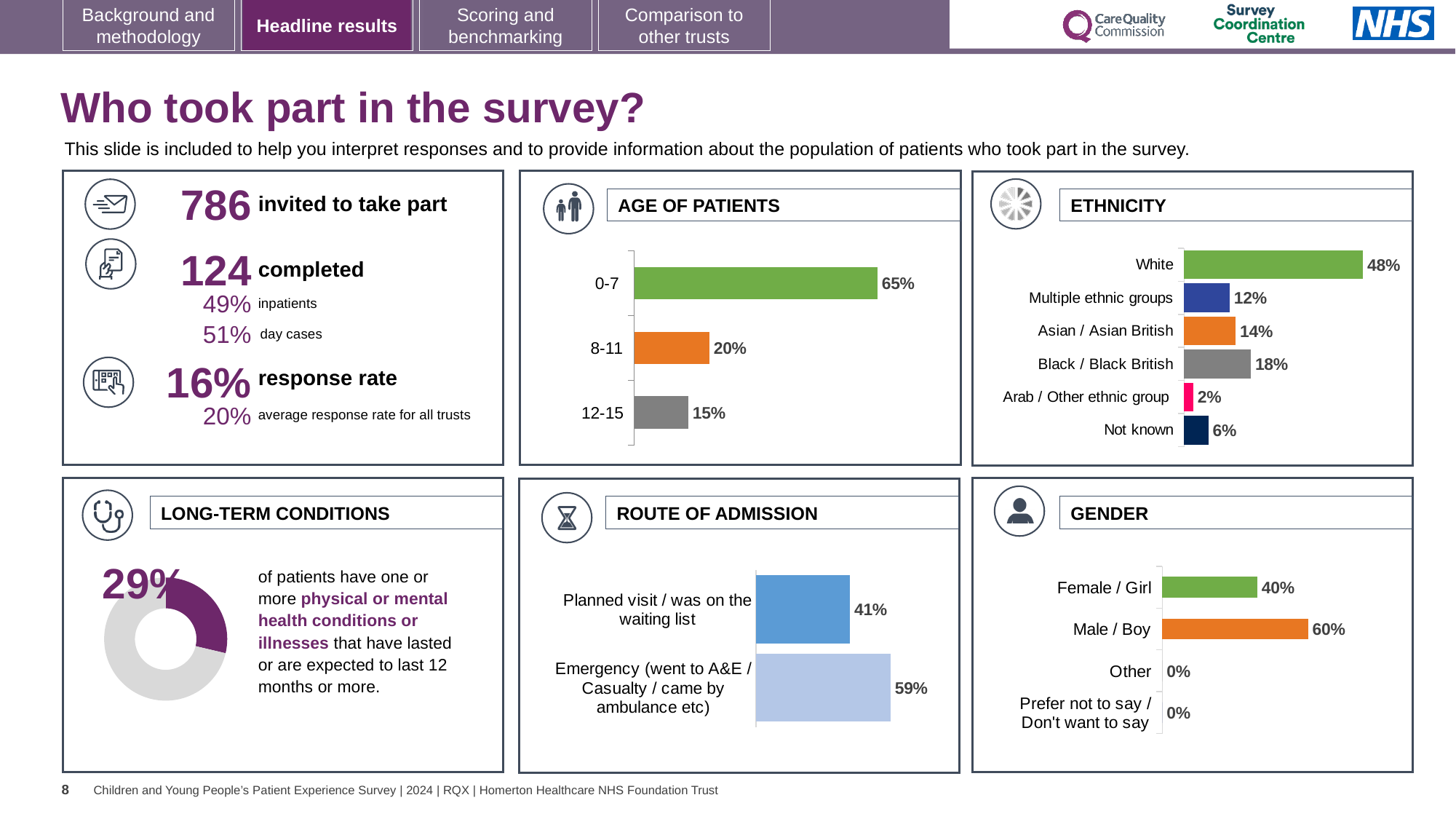
In the GENDER chart, what percentage of patients are Male / Boy? 60% In the ETHNICITY chart, what percentage of patients are Black / Black British? 18% What type of chart is used in the LONG-TERM CONDITIONS panel? Doughnut chart In the GENDER chart, what is the difference between Male / Boy and Female / Girl? 20% In the ETHNICITY chart, which is larger: Multiple ethnic groups or Asian / Asian British? Asian / Asian British In the ROUTE OF ADMISSION chart, what is the difference between the Emergency and Planned visit percentages? 18% In the AGE OF PATIENTS chart, what is the difference between the 8-11 and 12-15 age groups? 5% In the AGE OF PATIENTS chart, what percentage of patients are aged 0-7? 65% In the ETHNICITY chart, which ethnic group has the highest percentage? White In the AGE OF PATIENTS chart, which age group has the lowest percentage? 12-15 In the ETHNICITY chart, how many ethnic group categories are shown? 6 In the ROUTE OF ADMISSION chart, what percentage of patients came via Emergency (went to A&E / Casualty / came by ambulance etc)? 59%